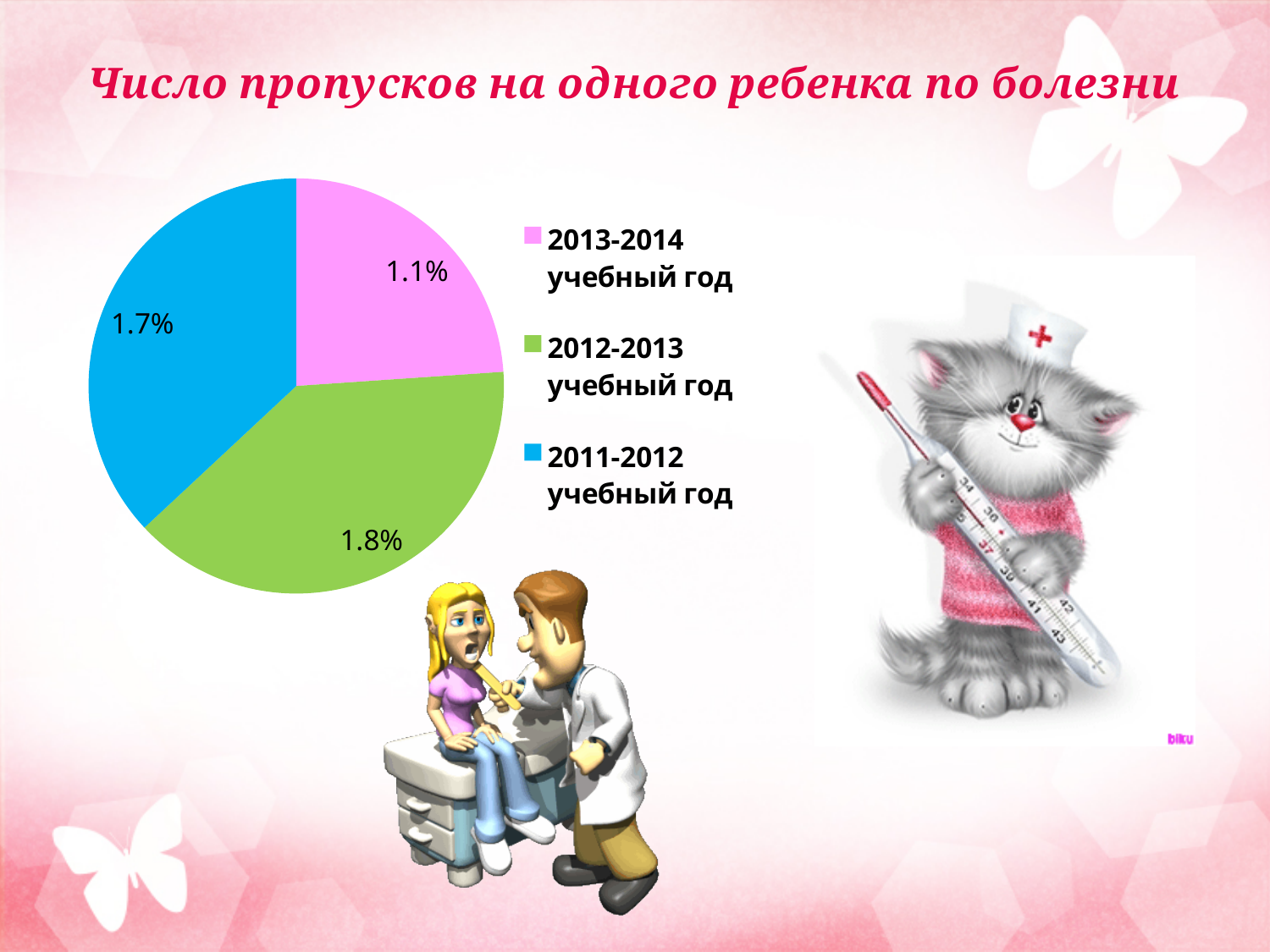
Which colour represents 2011-2012 учебный год in the legend? Blue What is the difference between the values for 2012-2013 and 2013-2014? 0.7% What value is shown for the 2011-2012 учебный год slice? 1.7% Which is larger, the value for 2011-2012 or the value for 2013-2014? 2011-2012 What type of chart is shown on the slide? Pie chart How many slices does the pie chart have? 3 What is the difference between the values for 2011-2012 and 2013-2014? 0.6% What value is shown for the 2013-2014 учебный год slice? 1.1% What value is shown for the 2012-2013 учебный год slice? 1.8% Which school year has the lowest value in the pie chart? 2013-2014 учебный год What is the title of the chart on the slide? Число пропусков на одного ребенка по болезни Which school year has the highest value in the pie chart? 2012-2013 учебный год